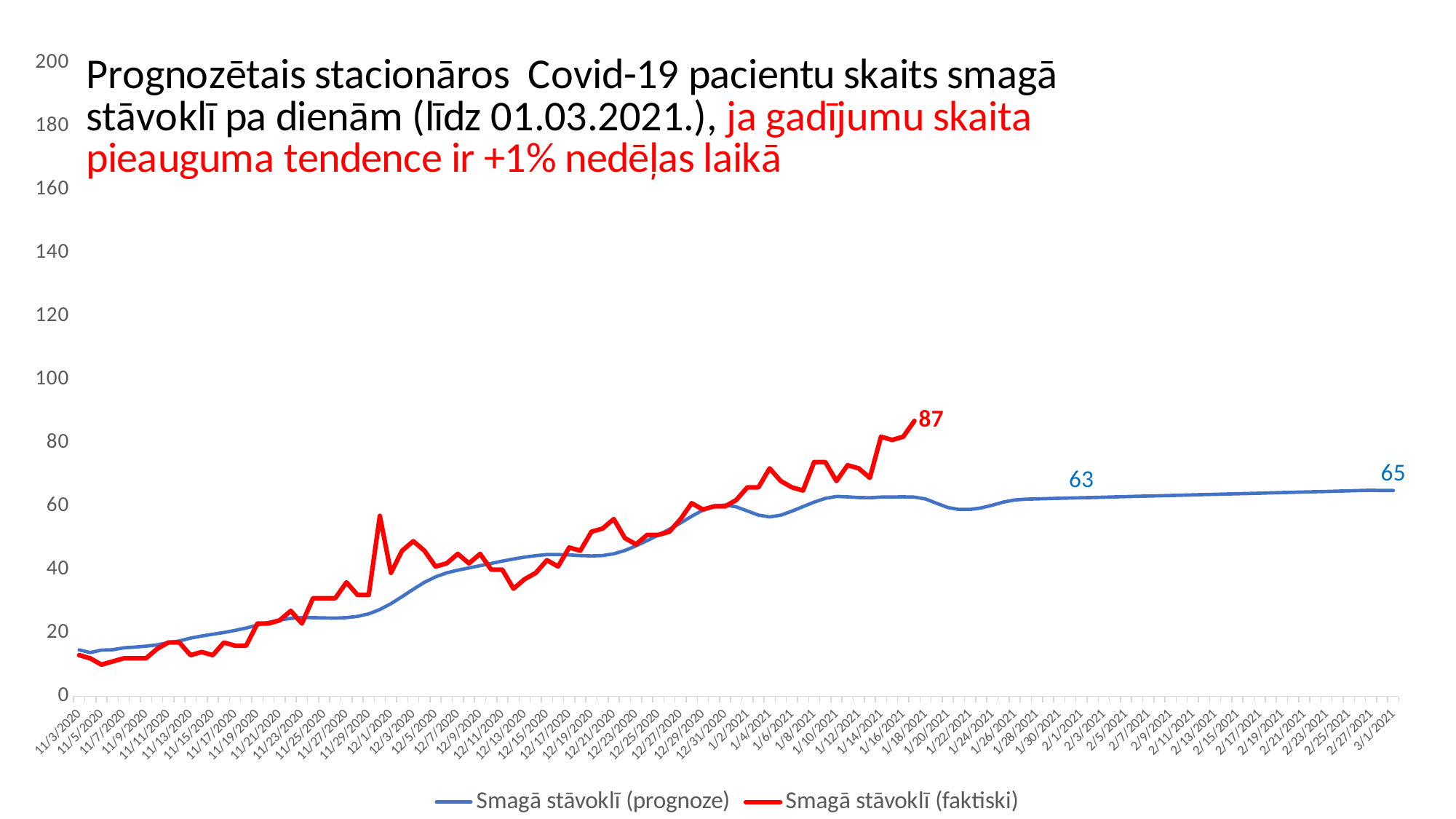
Which is larger: the last labeled value of the red actual line or the forecast value at 3/1/2021? the red actual line (87) Which two values are labeled on the blue 'Smagā stāvoklī (prognoze)' line? 63 and 65 Does the blue 'Smagā stāvoklī (prognoze)' line overall rise or fall from 11/3/2020 to 3/1/2021? rise What is the last labeled value on the red 'Smagā stāvoklī (faktiski)' line? 87 What kind of chart is shown on the slide? line chart What is the difference between the last labeled actual value (87) and the forecast value at 3/1/2021 (65)? 22 What is the value of the blue 'Smagā stāvoklī (prognoze)' line at 3/1/2021? 65 Is the peak of the red actual line around 12/1/2020 greater or less than 40? greater Which colour is used for the 'Smagā stāvoklī (faktiski)' series? red What are the two series named in the legend? Smagā stāvoklī (prognoze) and Smagā stāvoklī (faktiski) Is the value of the blue forecast line at 11/3/2020 greater or less than 20? less How many series does the legend list? 2